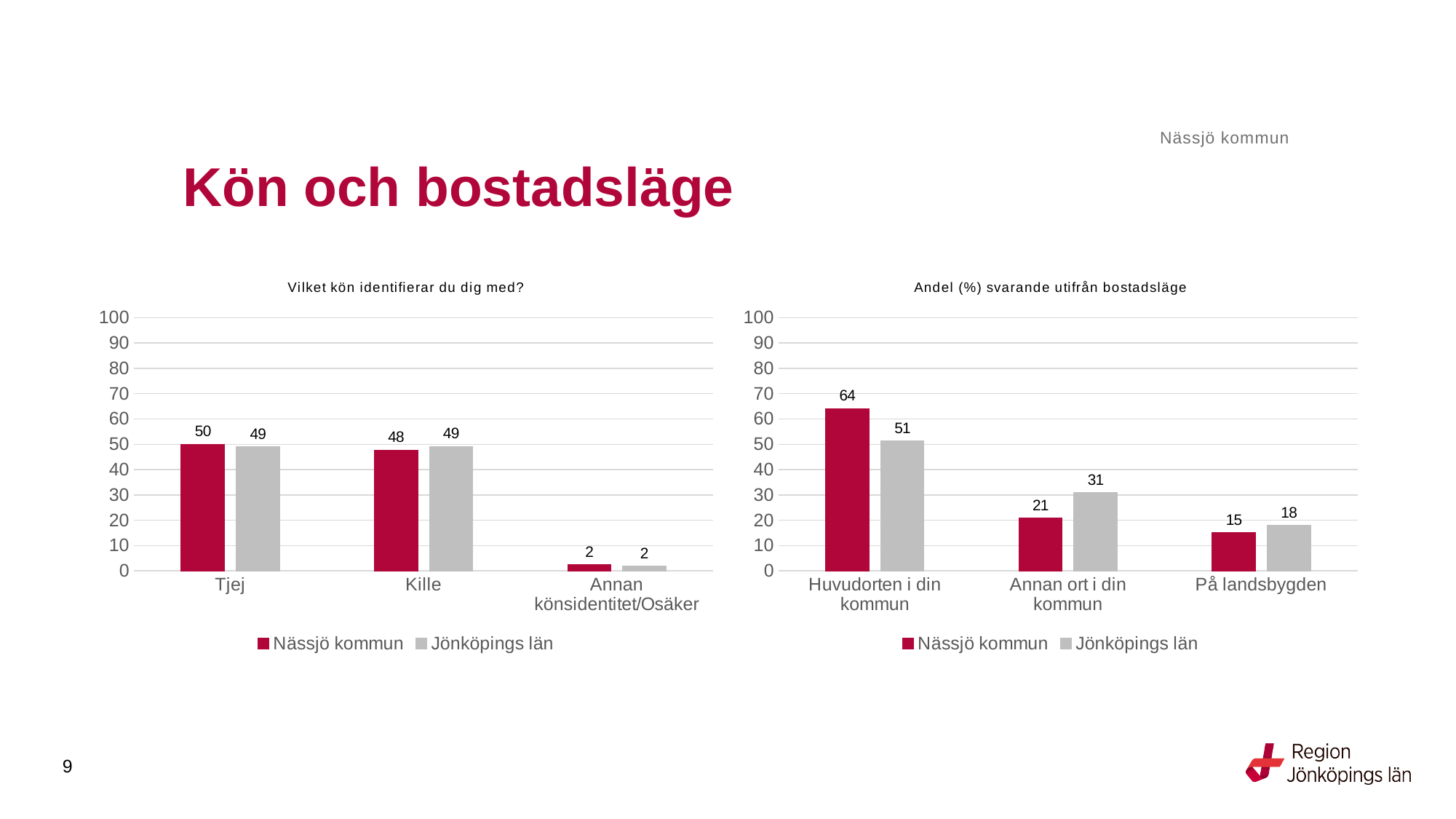
In the chart 'Vilket kön identifierar du dig med?', which category has the lowest value for Nässjö kommun? Annan könsidentitet/Osäker What kind of chart is the chart 'Andel (%) svarande utifrån bostadsläge'? Bar chart In the chart 'Andel (%) svarande utifrån bostadsläge', what is the difference between Nässjö kommun and Jönköpings län for Huvudorten i din kommun? 13 In the chart 'Andel (%) svarande utifrån bostadsläge', how many series does the legend list? 2 In the chart 'Andel (%) svarande utifrån bostadsläge', which category has the highest value for Jönköpings län? Huvudorten i din kommun In the chart 'Andel (%) svarande utifrån bostadsläge', which is larger for På landsbygden: Nässjö kommun or Jönköpings län? Jönköpings län In the chart 'Vilket kön identifierar du dig med?', how many categories are shown on the x axis? 3 In the chart 'Vilket kön identifierar du dig med?', what is the value for Nässjö kommun for Tjej? 50 In the chart 'Vilket kön identifierar du dig med?', what is the value for Nässjö kommun for Annan könsidentitet/Osäker? 2 In the chart 'Vilket kön identifierar du dig med?', what is the value for Jönköpings län for Kille? 49 In the chart 'Andel (%) svarande utifrån bostadsläge', what is the value for Jönköpings län for Annan ort i din kommun? 31 In the chart 'Andel (%) svarande utifrån bostadsläge', what is the value for Nässjö kommun for Huvudorten i din kommun? 64